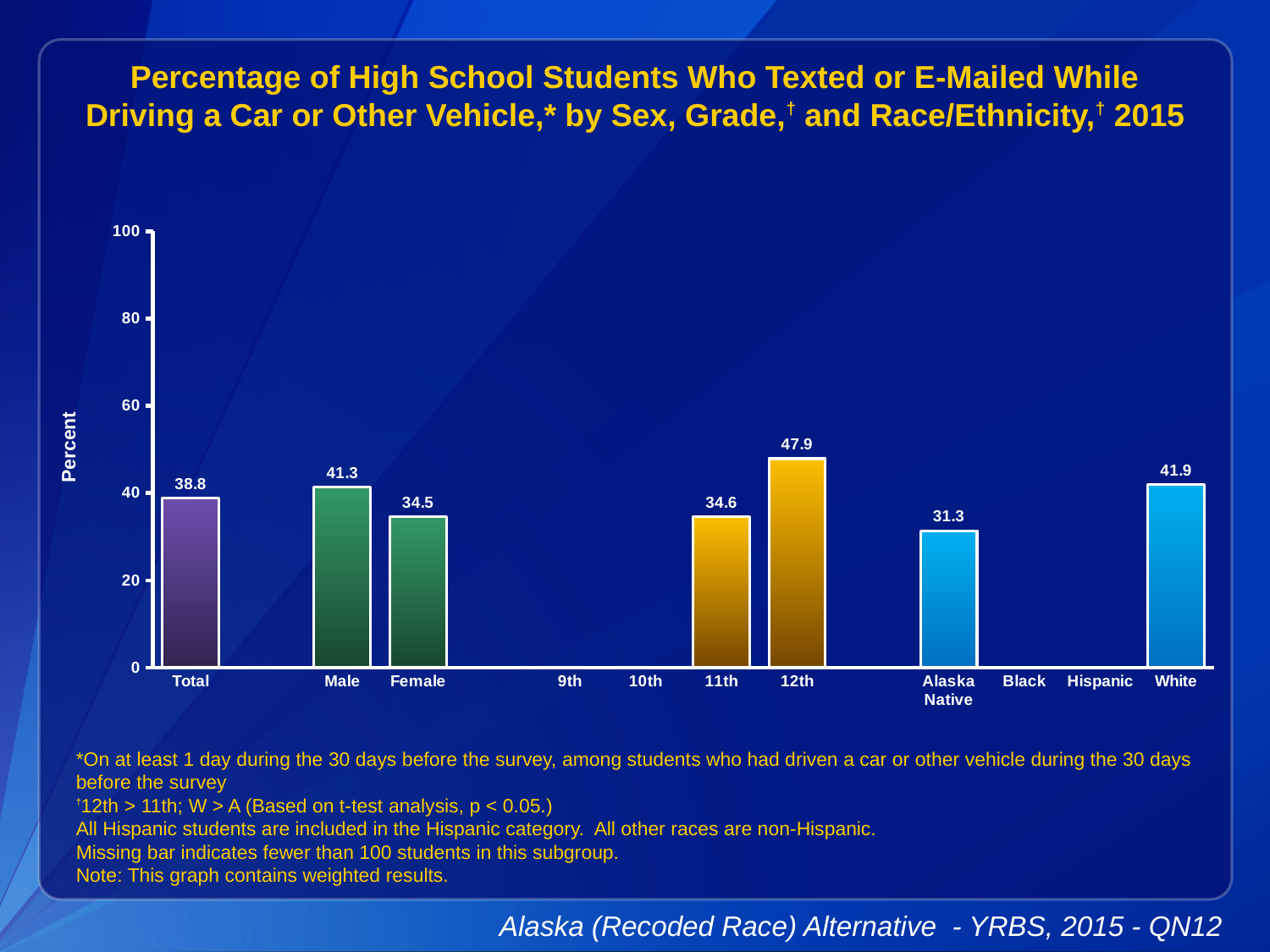
Which category with a bar has the lowest value? Alaska Native What is the value for Alaska Native? 31.3 Which is larger, the value for 11th grade or 12th grade? 12th What is the value for 12th grade? 47.9 Which category has the highest value? 12th Is the value for White greater or less than 40? greater What is the value for Female? 34.5 What is the difference between the values for Male and Female? 6.8 What is the value for Male? 41.3 What is the value for Total? 38.8 What is the label of the y axis? Percent What kind of chart is shown on the slide? bar chart